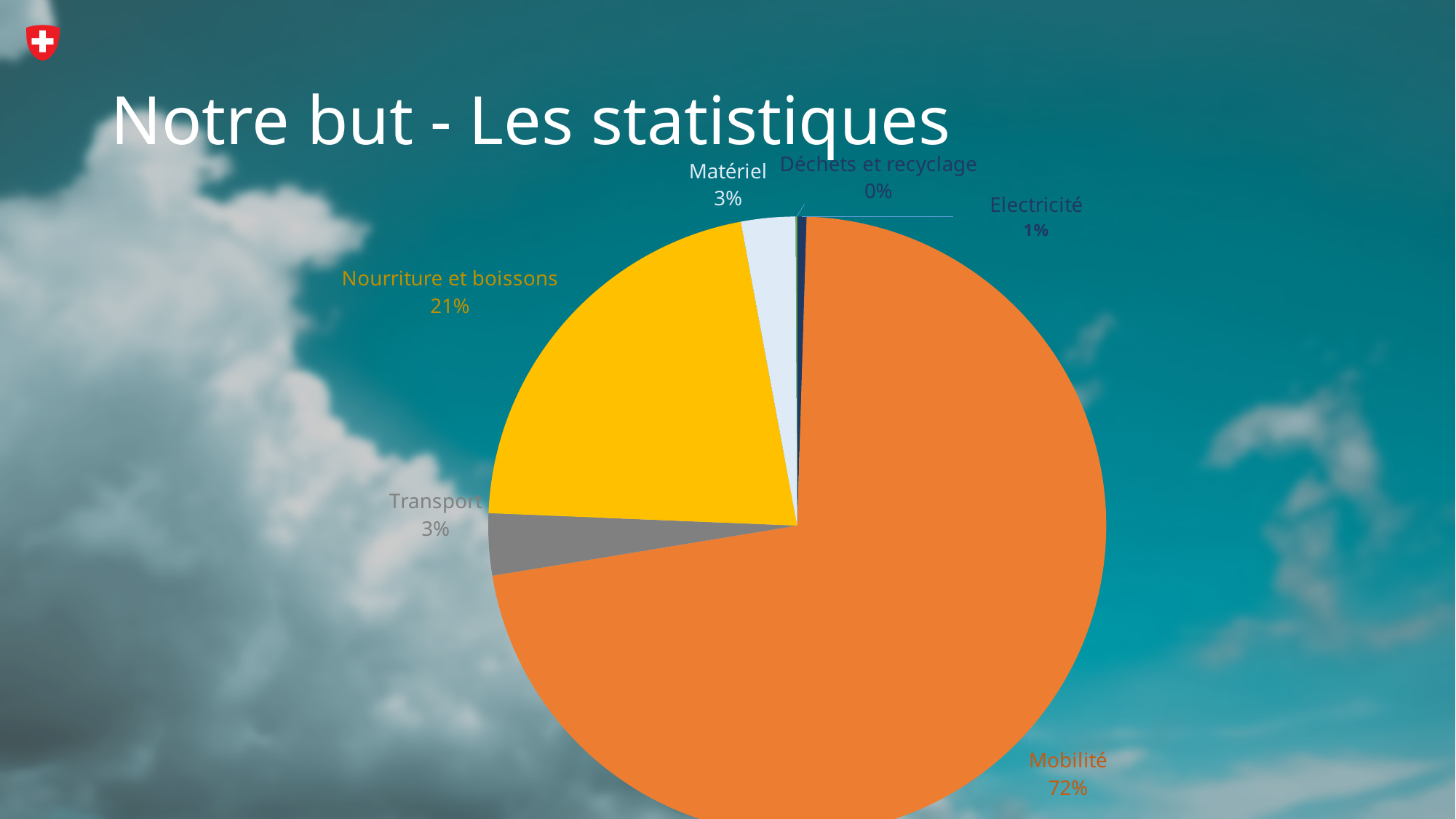
What share of the pie does Mobilité represent? 72% What is the difference in percentage points between Mobilité and Nourriture et boissons? 51 Which category has the smallest slice of the pie? Déchets et recyclage What share of the pie does Electricité represent? 1% What share of the pie does Transport represent? 3% What share of the pie does Nourriture et boissons represent? 21% How many categories are shown in the pie chart? 6 Which is larger, the share for Nourriture et boissons or the share for Matériel? Nourriture et boissons What is the title of the slide containing the pie chart? Notre but - Les statistiques What kind of chart is shown on the slide? pie chart What share of the pie does Déchets et recyclage represent? 0% Which category has the largest slice of the pie? Mobilité